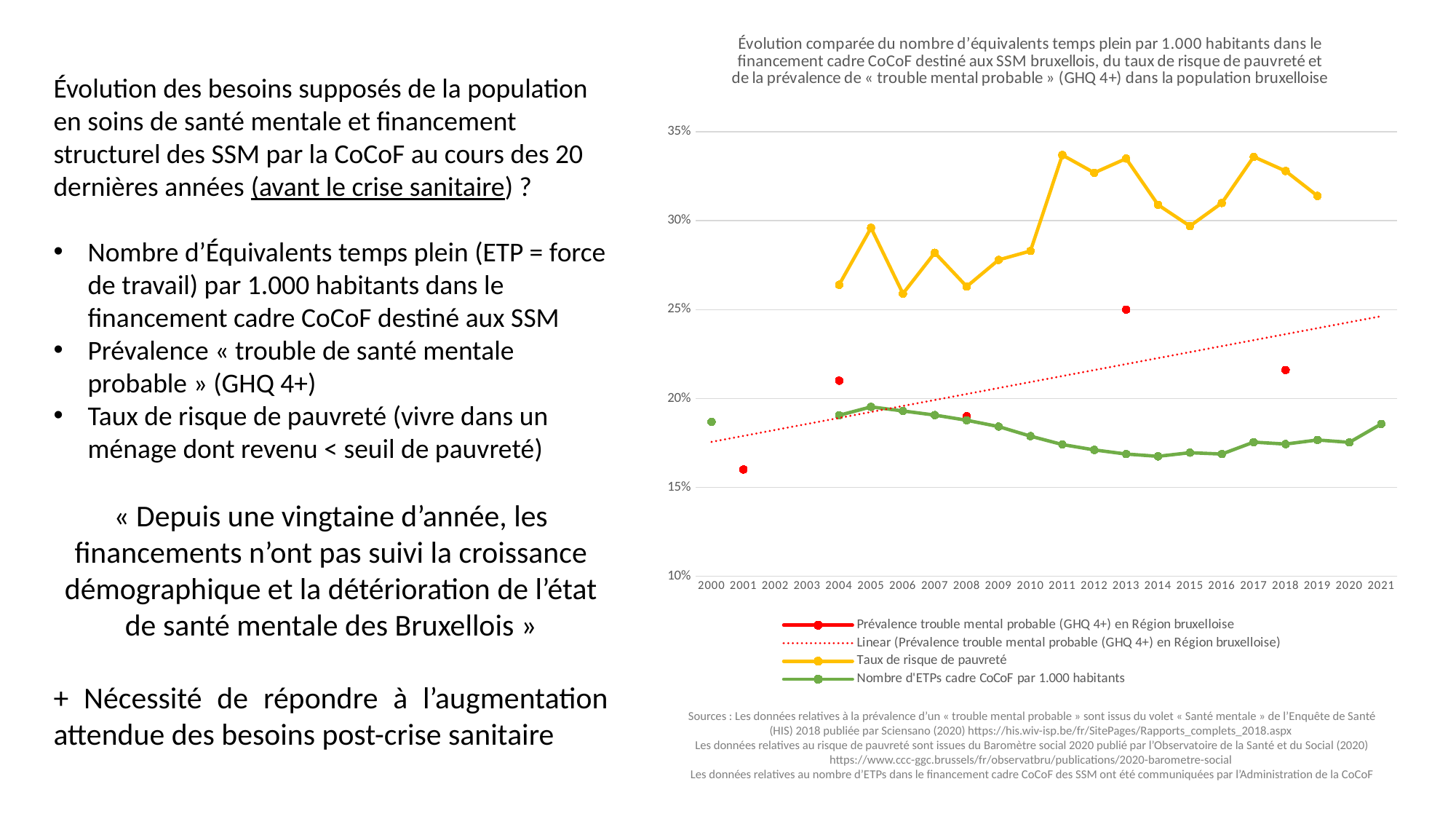
In which year is the Prévalence trouble mental probable (GHQ 4+) series at its highest? 2013 Which is larger for Taux de risque de pauvreté: the value in 2011 or the value in 2015? 2011 Is the value for Taux de risque de pauvreté in 2006 greater or less than 30%? less In which year is the Prévalence trouble mental probable (GHQ 4+) series at its lowest? 2001 What kind of chart is shown on the slide? line chart Is the value for Prévalence trouble mental probable (GHQ 4+) in 2001 greater or less than 20%? less Is the value for Taux de risque de pauvreté in 2019 greater or less than 30%? greater How many data points are plotted for the Prévalence trouble mental probable (GHQ 4+) series? 5 Does the Nombre d'ETPs cadre CoCoF par 1.000 habitants series rise or fall between 2005 and 2014? fall How many series does the chart legend list? 4